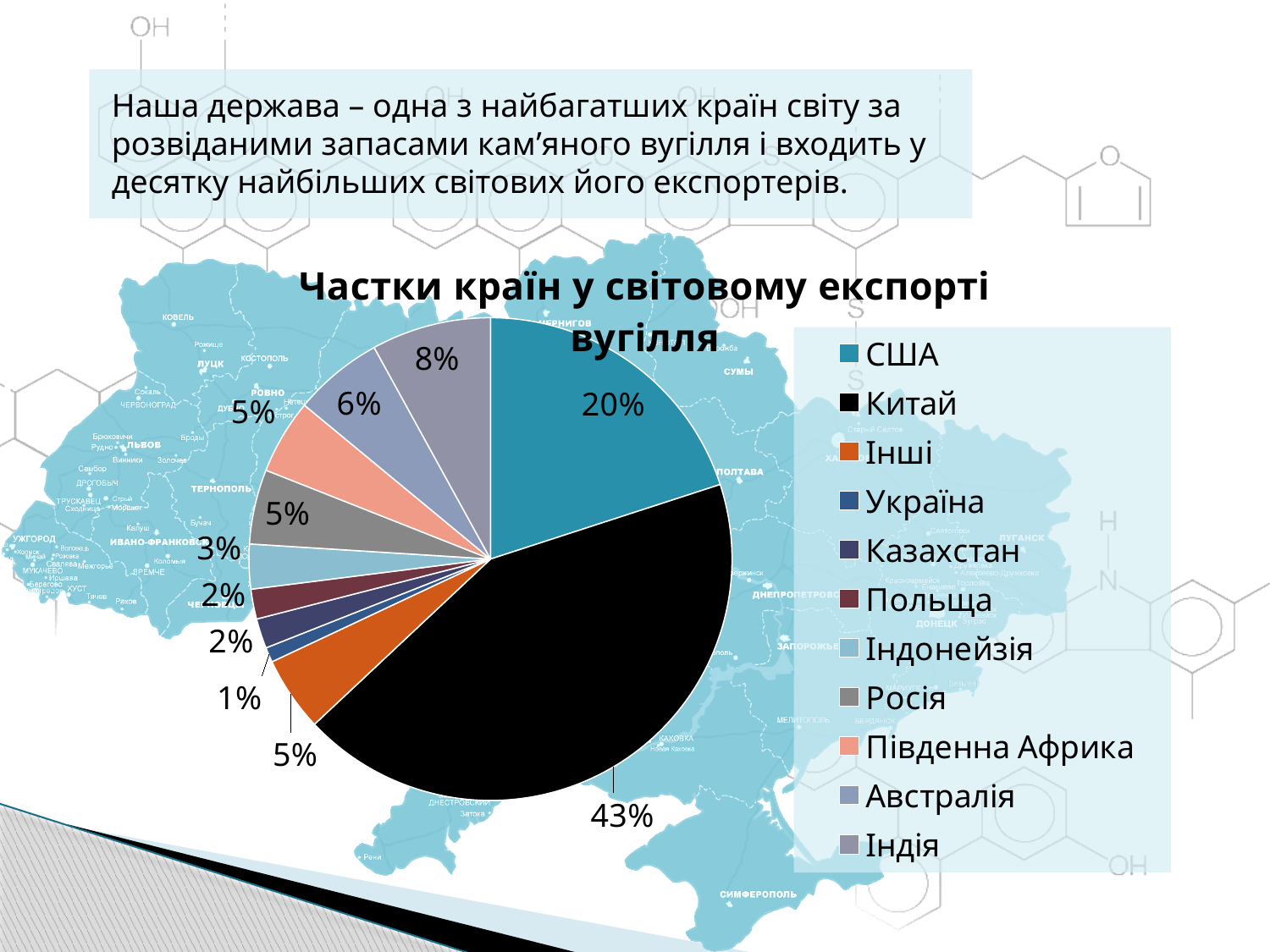
What share does Австралія have in the chart? 6% What share of world coal exports does США have according to the chart? 20% How many entries does the chart legend list? 11 Which country has the smallest slice of the pie? Україна What share does Індія have in the chart? 8% What is the difference between the shares of Китай and США? 23% What share of world coal exports does Китай have according to the chart? 43% What share does Україна have in the chart? 1% Which country has the largest slice of the pie? Китай What kind of chart is shown on the slide? pie chart Which has a larger share, Індія or Росія? Індія What is the title of the chart? Частки країн у світовому експорті вугілля